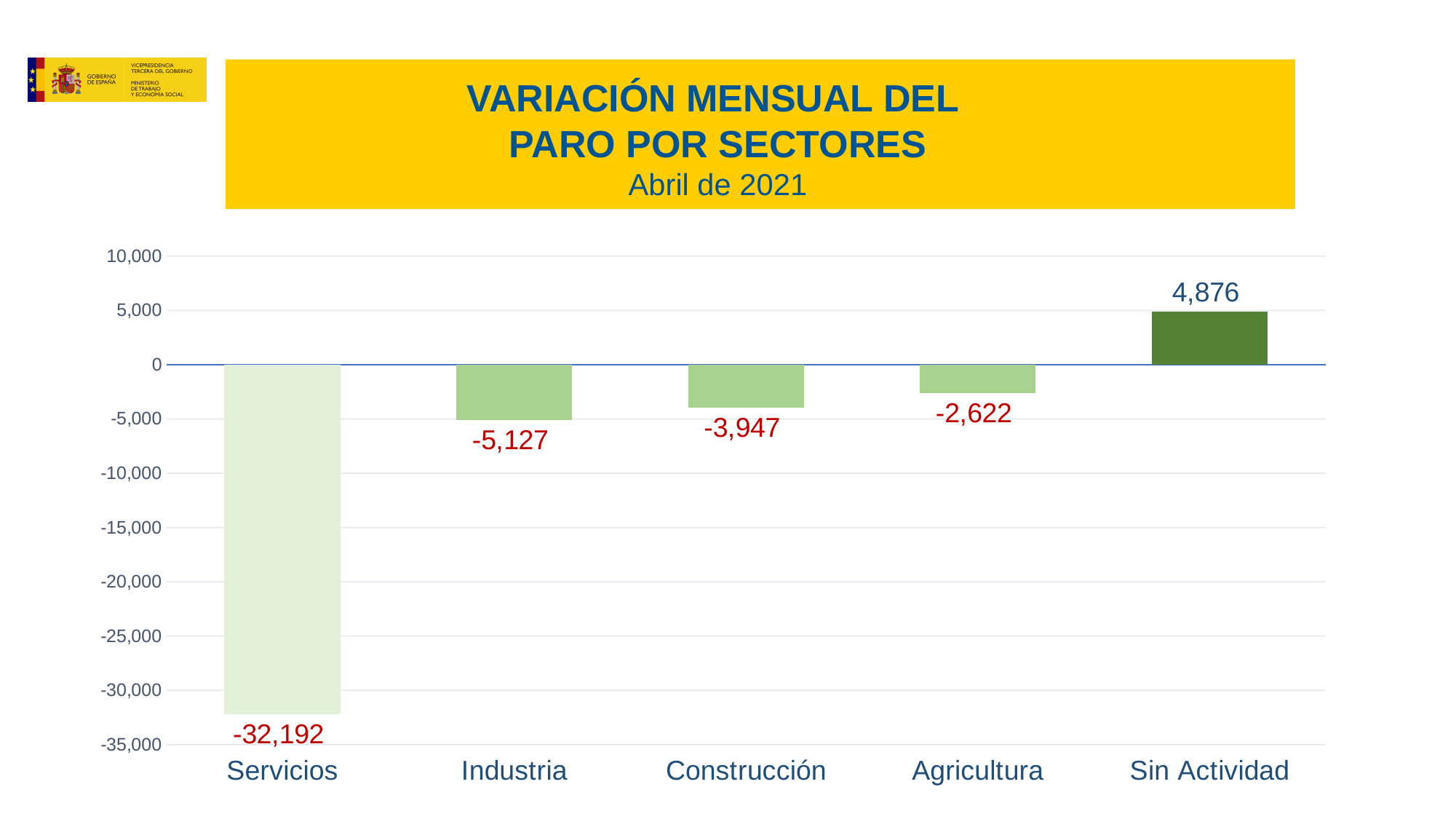
What kind of chart is shown on the slide? Bar chart Which sector has the highest value? Sin Actividad What is the value for Servicios? -32,192 What is the value for Sin Actividad? 4,876 What is the difference between the values for Industria and Construcción? 1,180 What is the value for Agricultura? -2,622 What is the value for Industria? -5,127 What is the value for Construcción? -3,947 Which sector has the lowest value? Servicios Which is larger, the value for Agricultura or the value for Industria? Agricultura How many sectors are shown on the chart? 5 What month and year does the chart title refer to? Abril de 2021